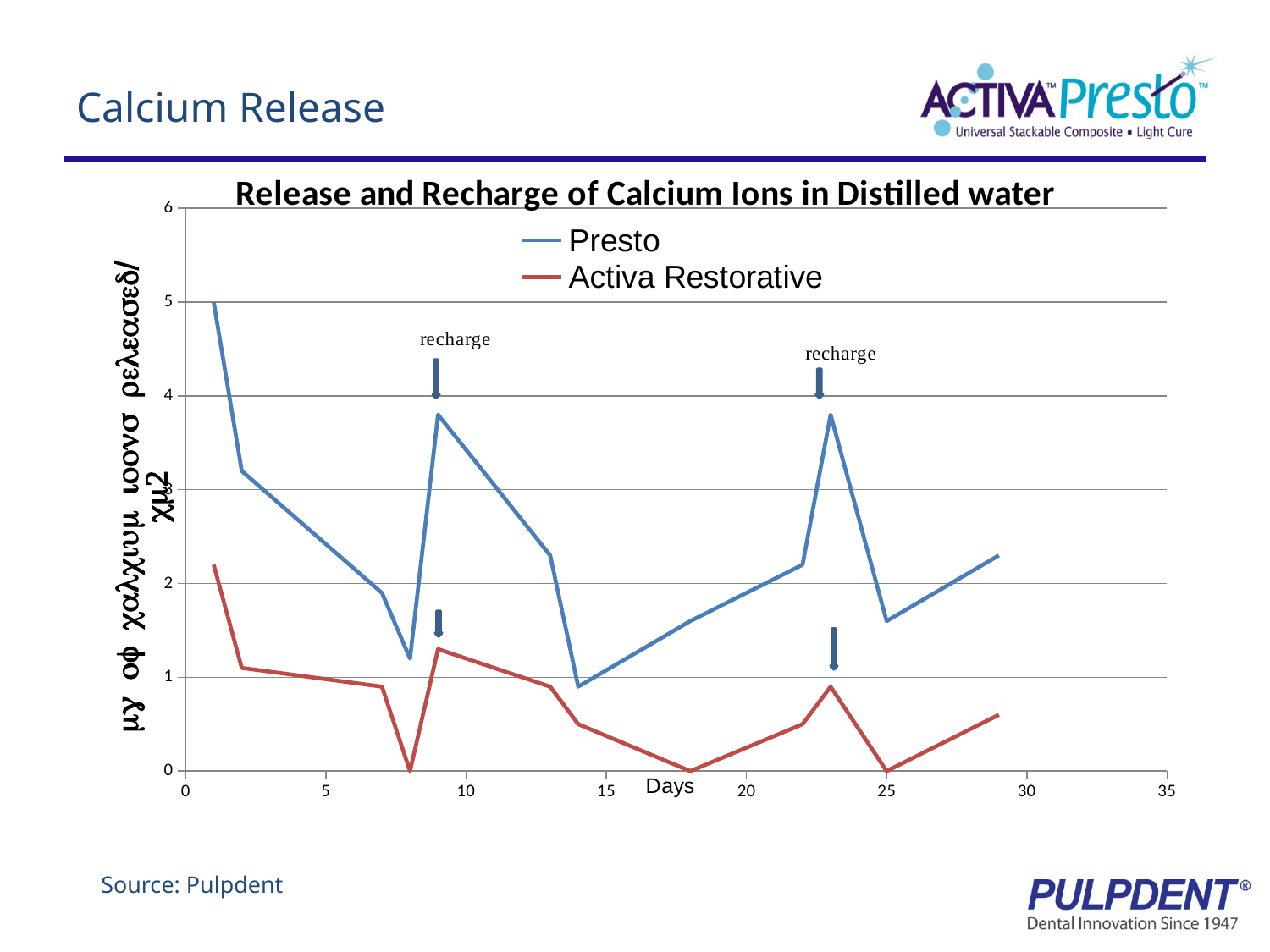
Is the Presto peak after the first recharge (around day 9) greater or less than 4? less Which series has the higher values throughout the chart, Presto or Activa Restorative? Presto Does the Presto line rise or fall between day 1 and day 8? fall What is the label of the x axis? Days What is the title of the chart? Release and Recharge of Calcium Ions in Distilled water Is the starting value of the Activa Restorative line at day 1 greater or less than 2? greater Which series is plotted in red? Activa Restorative Is the starting value of the Presto line at day 1 greater or less than 4? greater How many series does the legend list? 2 What kind of chart is shown on the slide? line chart What is the lowest value reached by the Activa Restorative line? 0